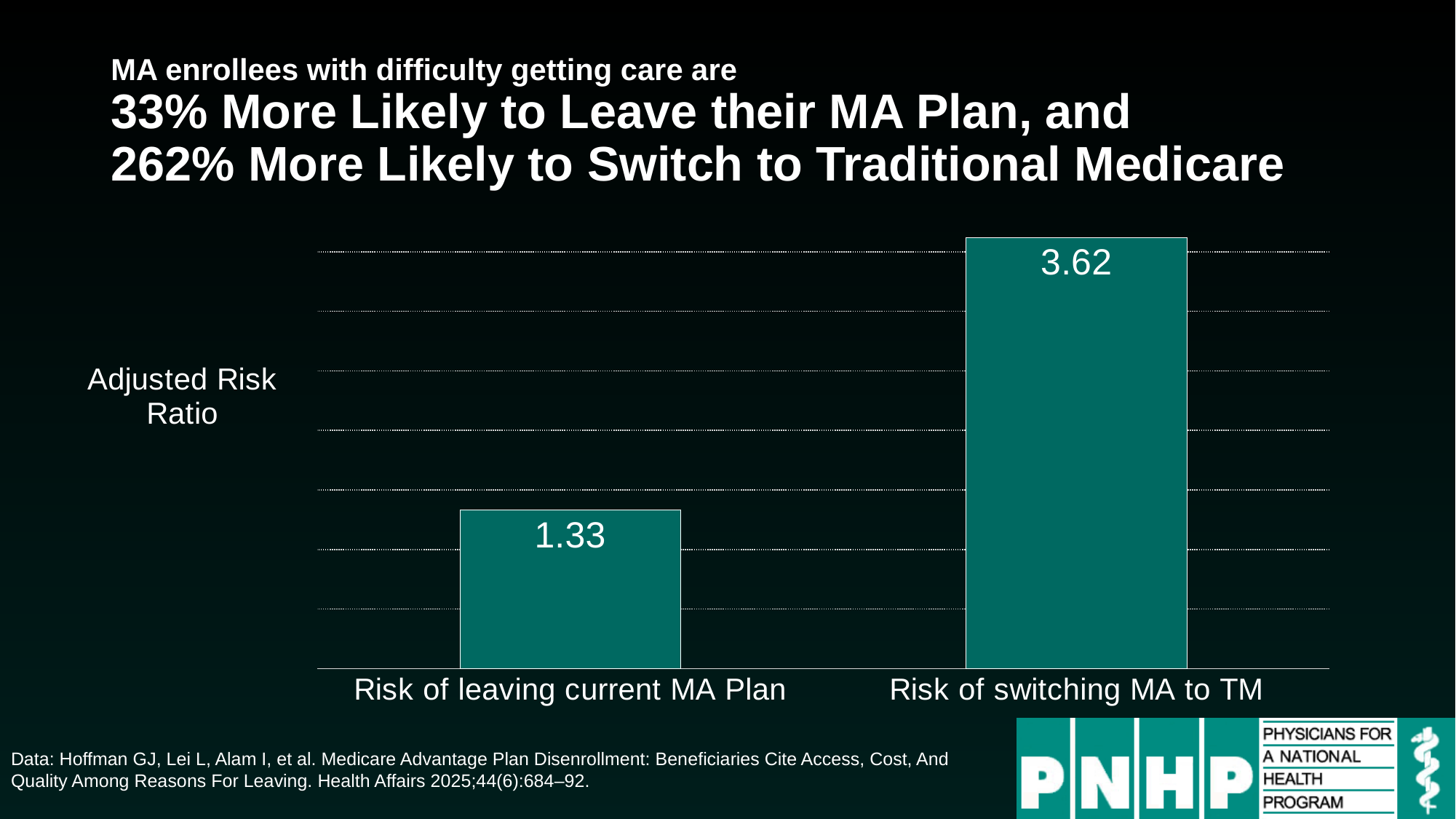
Which category has the lowest adjusted risk ratio? Risk of leaving current MA Plan What is the difference between the adjusted risk ratio for Risk of switching MA to TM and Risk of leaving current MA Plan? 2.29 What is the label on the vertical axis of the chart? Adjusted Risk Ratio How many categories are shown in the chart? 2 What colour are the bars in the chart? Teal What is the adjusted risk ratio for Risk of leaving current MA Plan? 1.33 Which is larger: the adjusted risk ratio for Risk of leaving current MA Plan or for Risk of switching MA to TM? Risk of switching MA to TM What is the adjusted risk ratio for Risk of switching MA to TM? 3.62 Which category has the highest adjusted risk ratio? Risk of switching MA to TM What kind of chart is shown on the slide? Bar chart